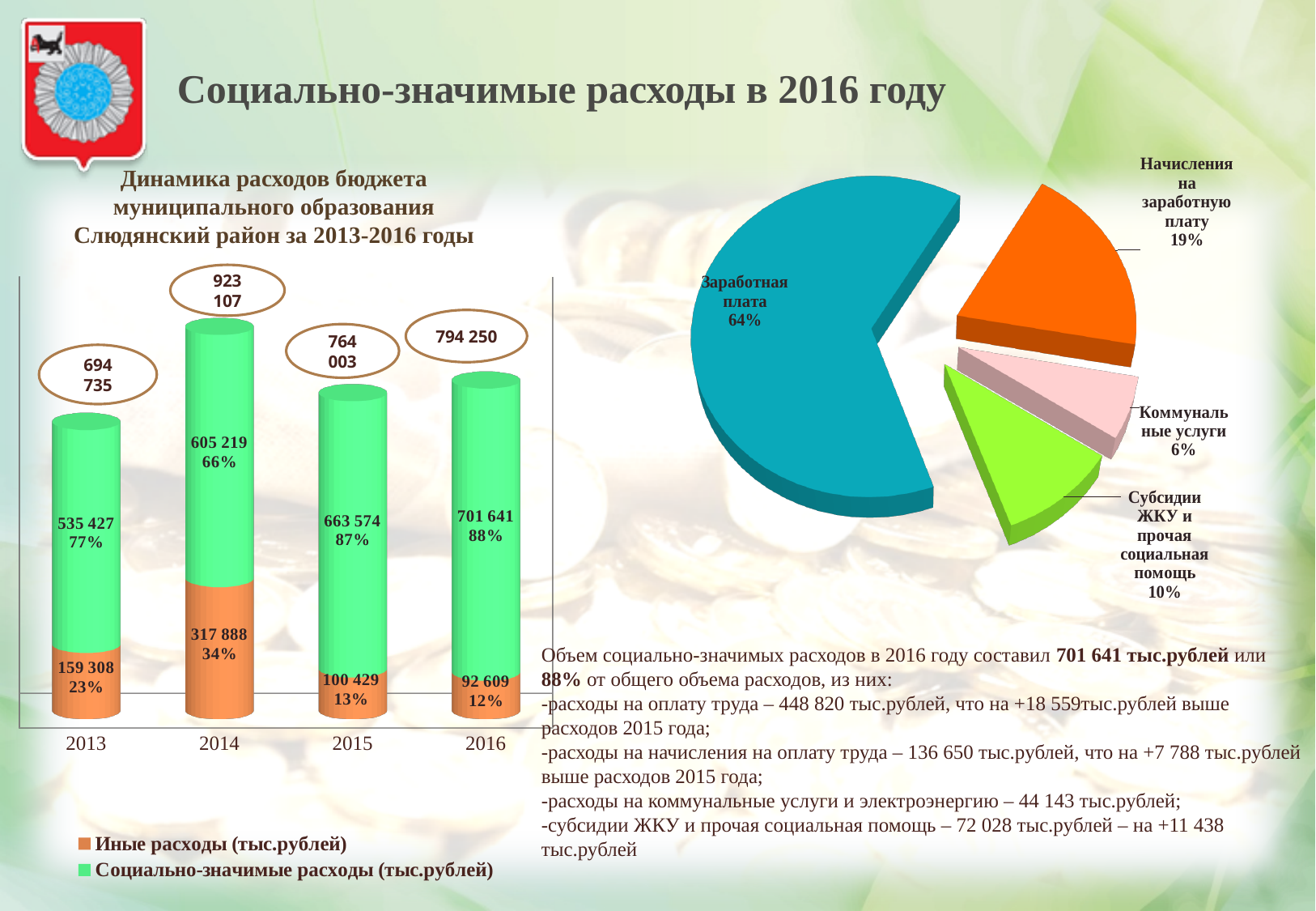
In the bar chart on the left, how many years are shown on the x axis? 4 In the bar chart on the left, what is the value of Иные расходы for 2014? 317 888 In the bar chart on the left, what is the value of Социально-значимые расходы for 2016? 701 641 In the pie chart on the right, what share does Заработная плата have? 64% In the bar chart on the left, how many series does the legend list? 2 In the bar chart on the left, what is the total of the stacked bar for 2013? 694 735 In the bar chart on the left, which year has the lowest value of Иные расходы? 2016 What type of chart is the chart on the left of the slide? Stacked bar chart In the bar chart on the left, what is the difference between Социально-значимые расходы in 2016 and in 2015? 38 067 In the pie chart on the right, which slice is the smallest? Коммунальные услуги In the bar chart on the left, which year has the highest total expenditure? 2014 In the bar chart on the left, which is larger: Иные расходы in 2013 or in 2015? 2013